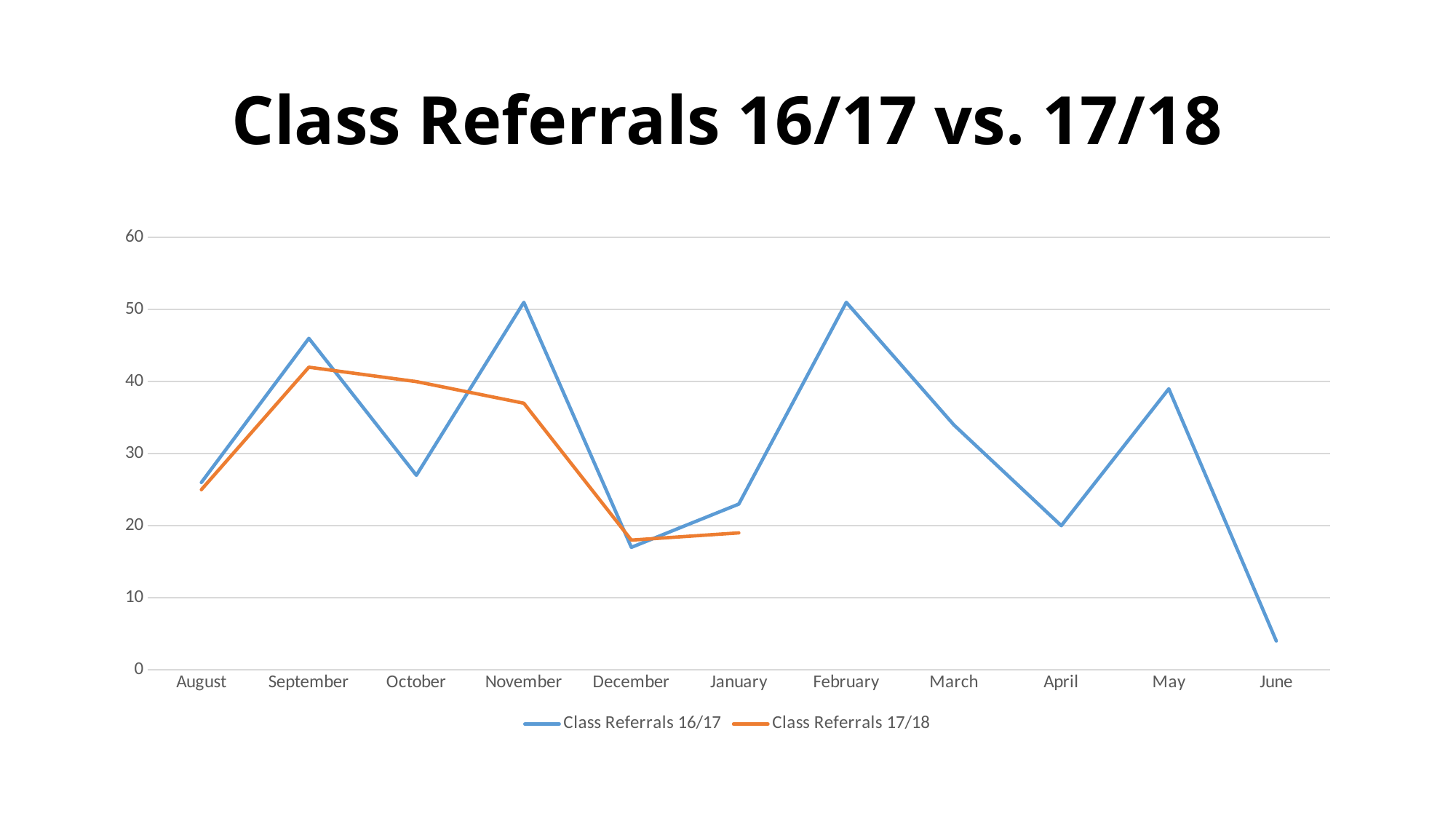
Is the value for Class Referrals 16/17 in September greater or less than 40? greater Which month has the lowest value for Class Referrals 16/17? June In October, which series has the larger value, Class Referrals 16/17 or Class Referrals 17/18? Class Referrals 17/18 How many series does the legend list? 2 What kind of chart is shown on the slide? line chart Does the Class Referrals 17/18 line rise or fall from September to January? fall Is the value for Class Referrals 16/17 in June greater or less than 10? less Is the value for Class Referrals 17/18 in October greater or less than 30? greater How many months are shown on the x axis? 11 How many months have a plotted value for the Class Referrals 17/18 series? 6 In November, which series has the larger value, Class Referrals 16/17 or Class Referrals 17/18? Class Referrals 16/17